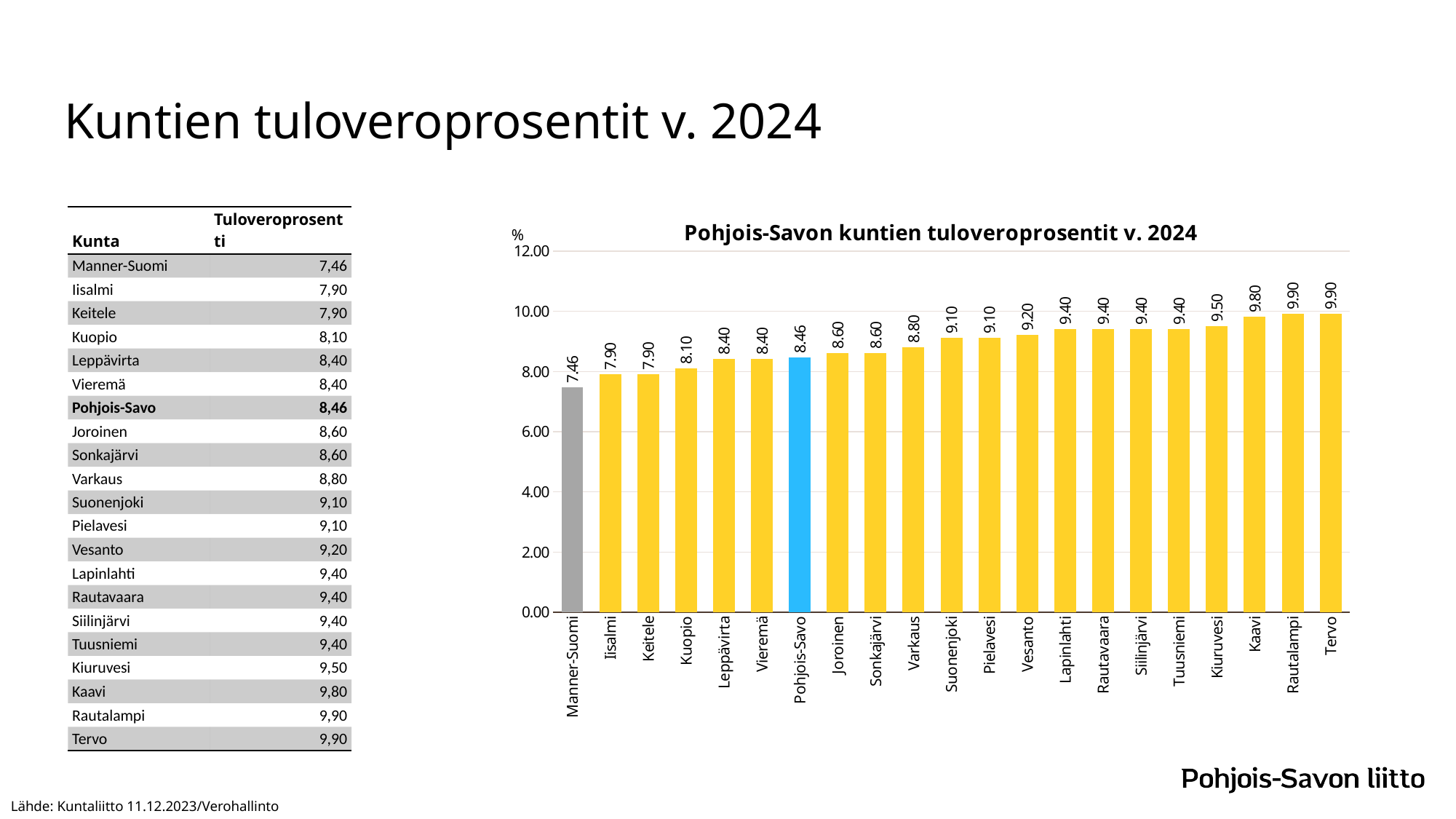
Is the value for Manner-Suomi greater or less than 8.00? less Which has a larger value, Varkaus or Vesanto? Vesanto What is the value for Pohjois-Savo in the chart? 8.46 What is the difference between the values for Kaavi and Kiuruvesi? 0.30 What is the difference between the values for Tervo and Manner-Suomi? 2.44 Which two categories share the highest value in the chart? Rautalampi and Tervo Which category has the lowest value in the chart? Manner-Suomi What is the value for Kiuruvesi in the chart? 9.50 Do the values rise or fall from left to right along the x axis? rise What is the value for Kuopio in the chart? 8.10 What kind of chart is shown on the slide? bar chart How many categories are plotted in the chart? 21